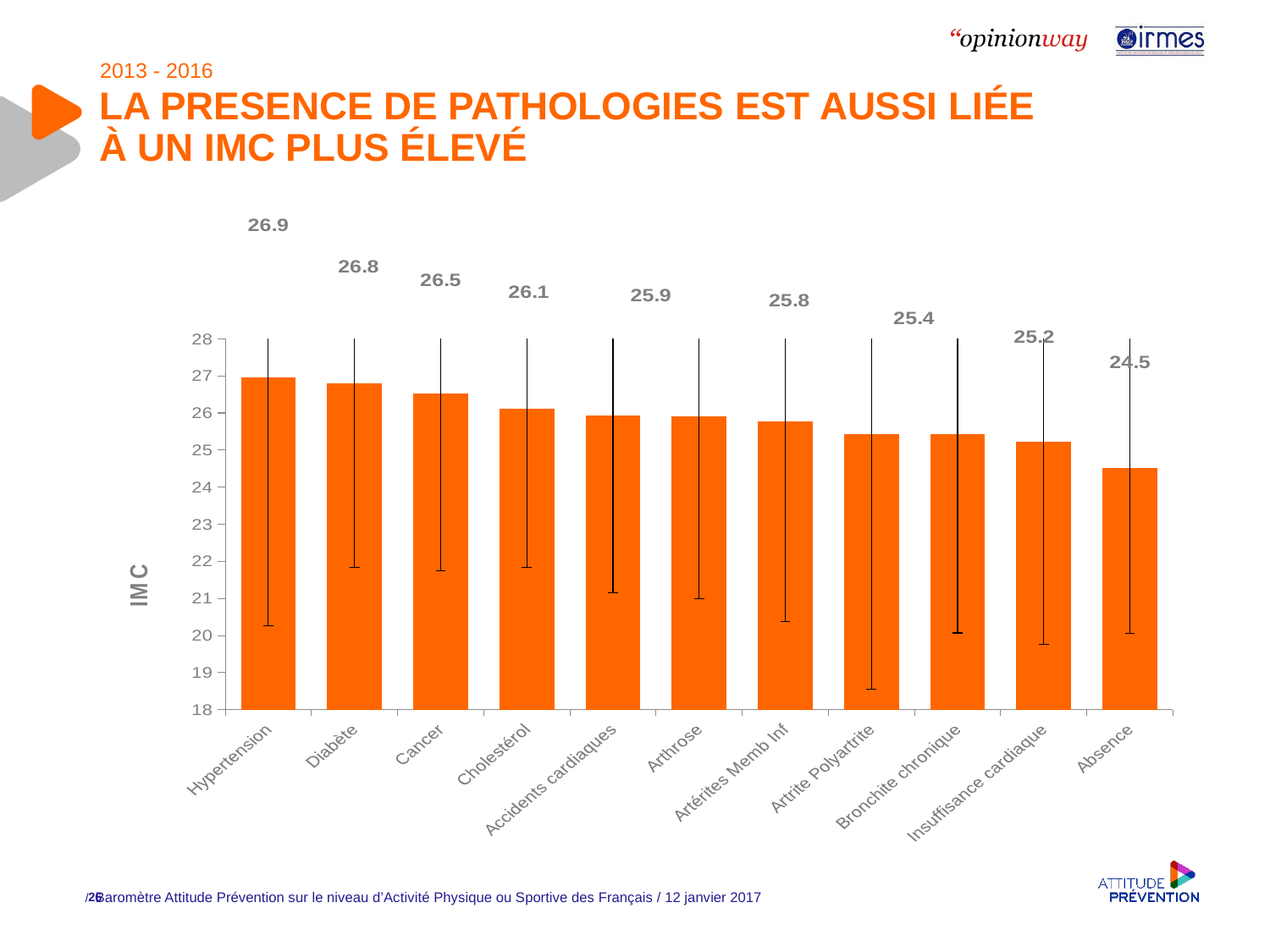
What is the difference between the IMC values for Hypertension and Absence? 2.4 What is the IMC value for Cancer? 26.5 What is the label on the y axis of the chart? IMC Which category has the highest IMC value? Hypertension Which has a higher IMC value, Cancer or Cholestérol? Cancer What kind of chart is shown on the slide? bar chart What is the IMC value for Diabète? 26.8 How many categories are shown on the x axis of the chart? 11 What is the IMC value for Absence? 24.5 Is the value for Bronchite chronique greater or less than 26? less What is the IMC value for Hypertension? 26.9 Which category has the lowest IMC value? Absence